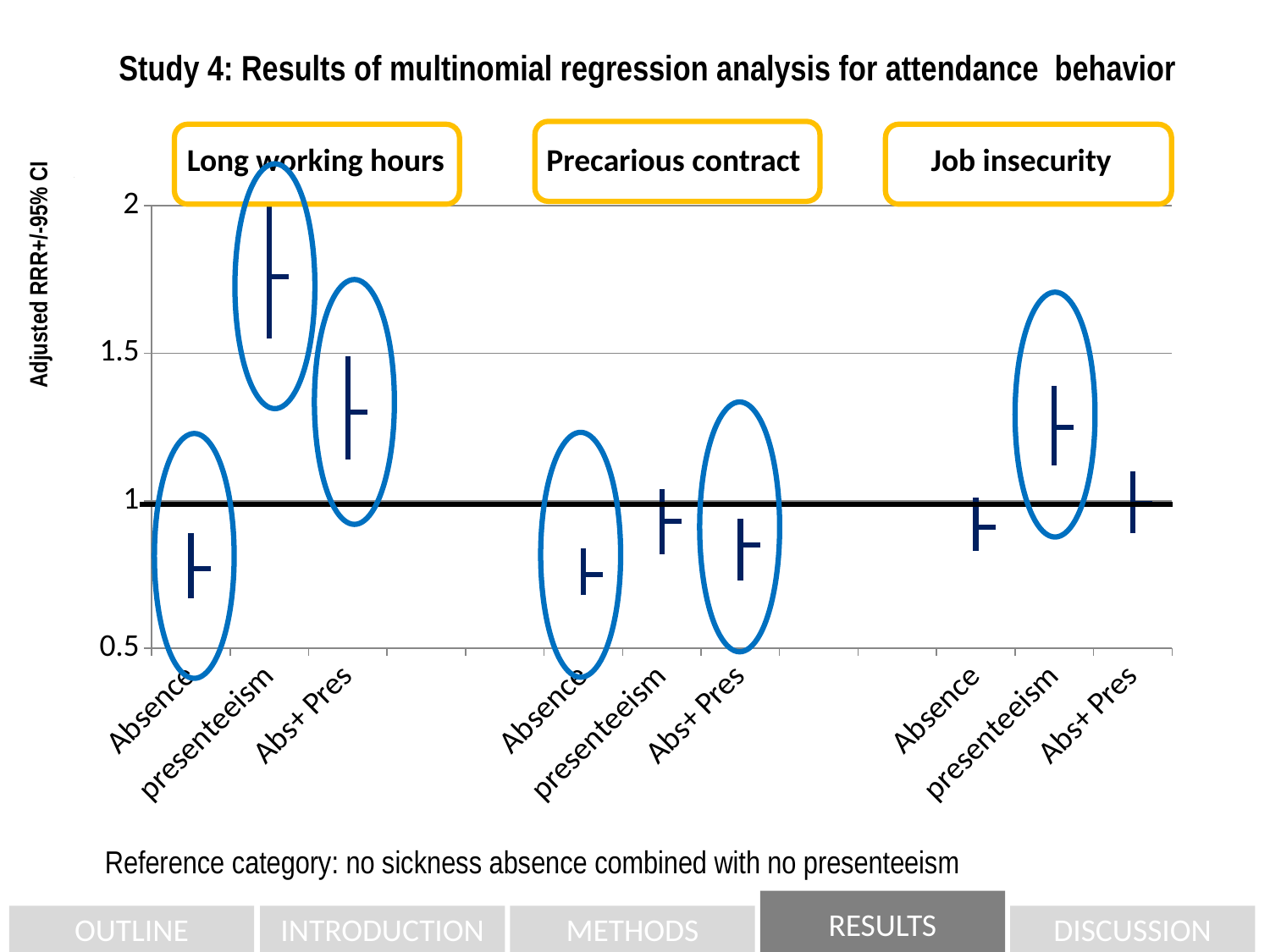
Within the Job insecurity group, which category has the highest point estimate? presenteeism What is the label of the y axis? Adjusted RRR+/-95% CI Within the Long working hours group, which category has the lowest point estimate? Absence How many exposure groups are labelled above the chart? 3 Under Long working hours, which is larger: the value for presenteeism or for Abs+ Pres? presenteeism Is the value for Absence under Long working hours greater or less than 1? less Is the value for presenteeism under Long working hours greater or less than 1.5? greater Is the value for Abs+ Pres under Long working hours greater or less than 1? greater Which point estimate is the highest on the chart? presenteeism under Long working hours How many point estimates (categories) are plotted on the chart? 9